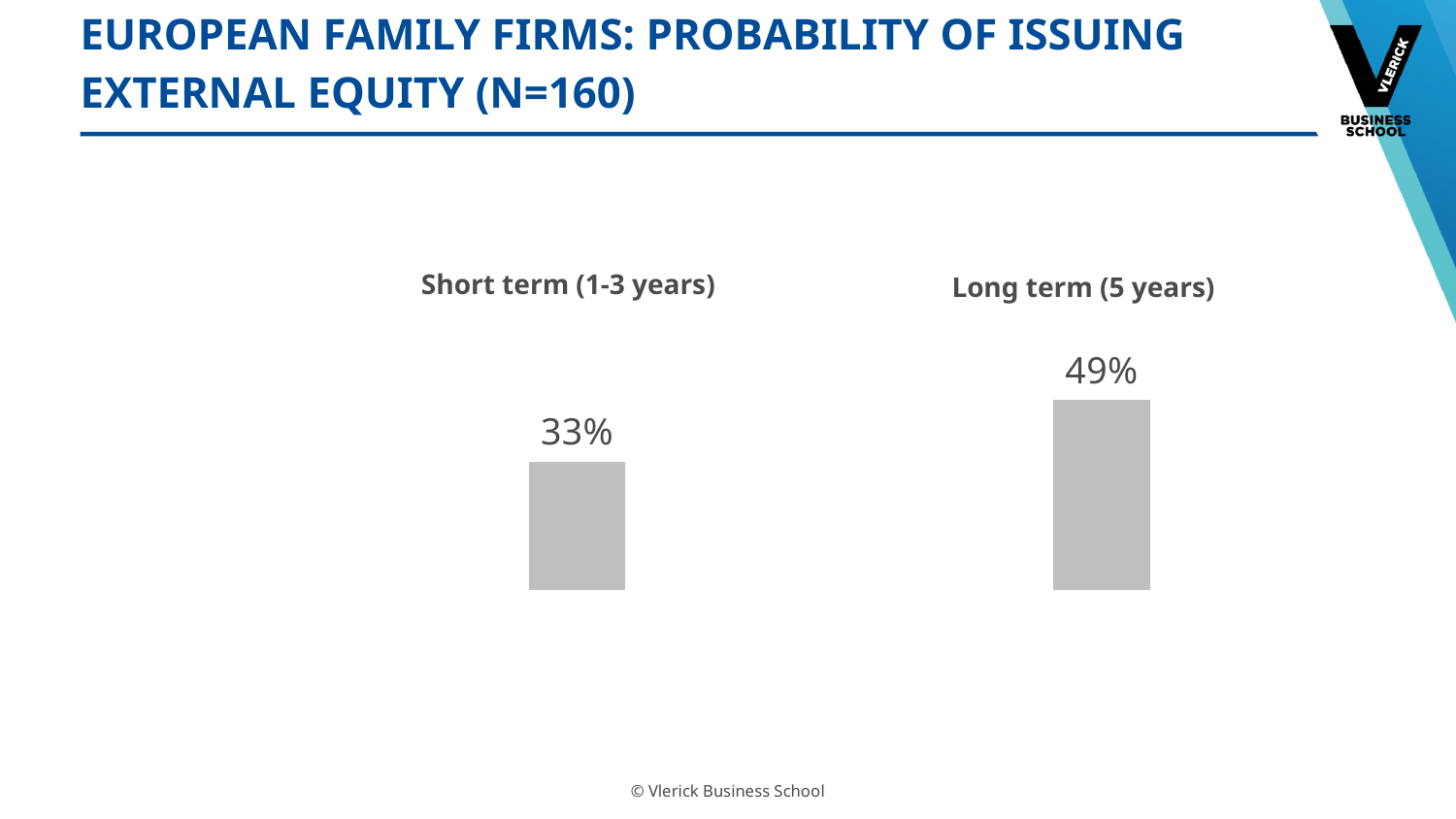
Which time horizon has the lower probability of issuing external equity? Short term (1-3 years) What colour are the bars in the chart? grey Which time horizon has the higher probability of issuing external equity? Long term (5 years) What kind of chart is shown on the slide? bar chart What is the probability of issuing external equity in the short term (1-3 years)? 33% Is the probability for the short term (1-3 years) larger or smaller than for the long term (5 years)? smaller What is the probability of issuing external equity in the long term (5 years)? 49% What is the difference in percentage points between the long term and short term probabilities? 16 percentage points Do the values rise or fall from the short term to the long term category? rise How many categories are shown in the chart? 2 What is the sample size (N) stated in the chart title? 160